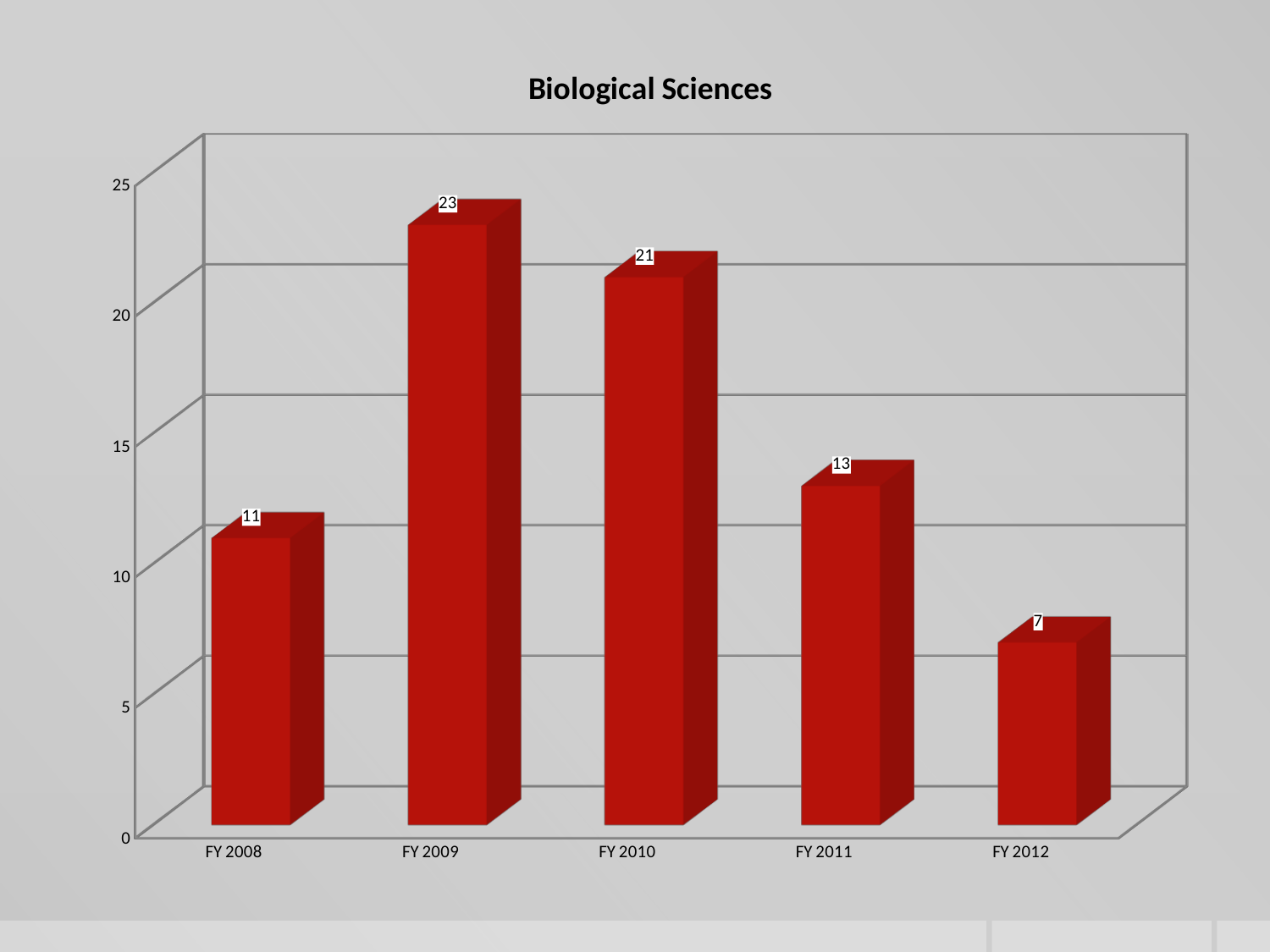
What is the difference between the values for FY 2010 and FY 2011? 8 What kind of chart is shown on the slide? Bar chart Which is larger, the value for FY 2008 or the value for FY 2011? FY 2011 How many fiscal years are shown on the chart? 5 What is the value for FY 2012? 7 What is the difference between the values for FY 2009 and FY 2012? 16 What is the value for FY 2009? 23 Is the value for FY 2010 greater or less than 20? greater Which fiscal year has the highest value? FY 2009 Which fiscal year has the lowest value? FY 2012 What is the value for FY 2011? 13 What is the title of the chart? Biological Sciences